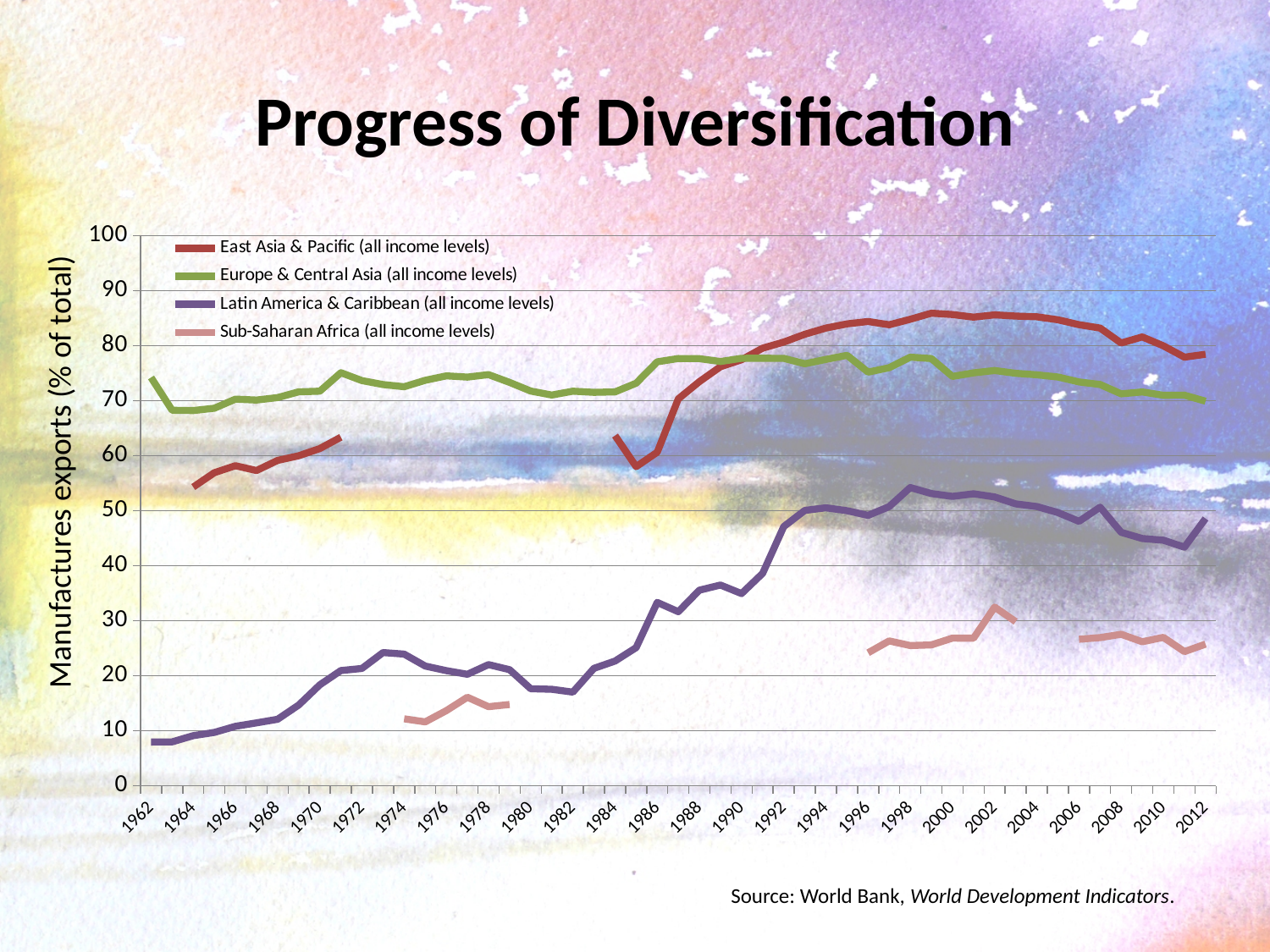
Is the value for Sub-Saharan Africa in 2002 greater or less than 30? greater What is the title of the chart? Progress of Diversification Is the value for Europe & Central Asia in 1962 greater or less than 70? greater How many series does the legend list? 4 In 1970, which is higher: Europe & Central Asia or East Asia & Pacific? Europe & Central Asia Does the Latin America & Caribbean line rise or fall from 1962 to 1998? rise Is the value for Latin America & Caribbean in 1962 greater or less than 10? less What is the label on the vertical axis? Manufactures exports (% of total) What kind of chart is shown on the slide? line chart Which series has the highest value in 2012? East Asia & Pacific (all income levels) Which series has the lowest value in 2012? Sub-Saharan Africa (all income levels)